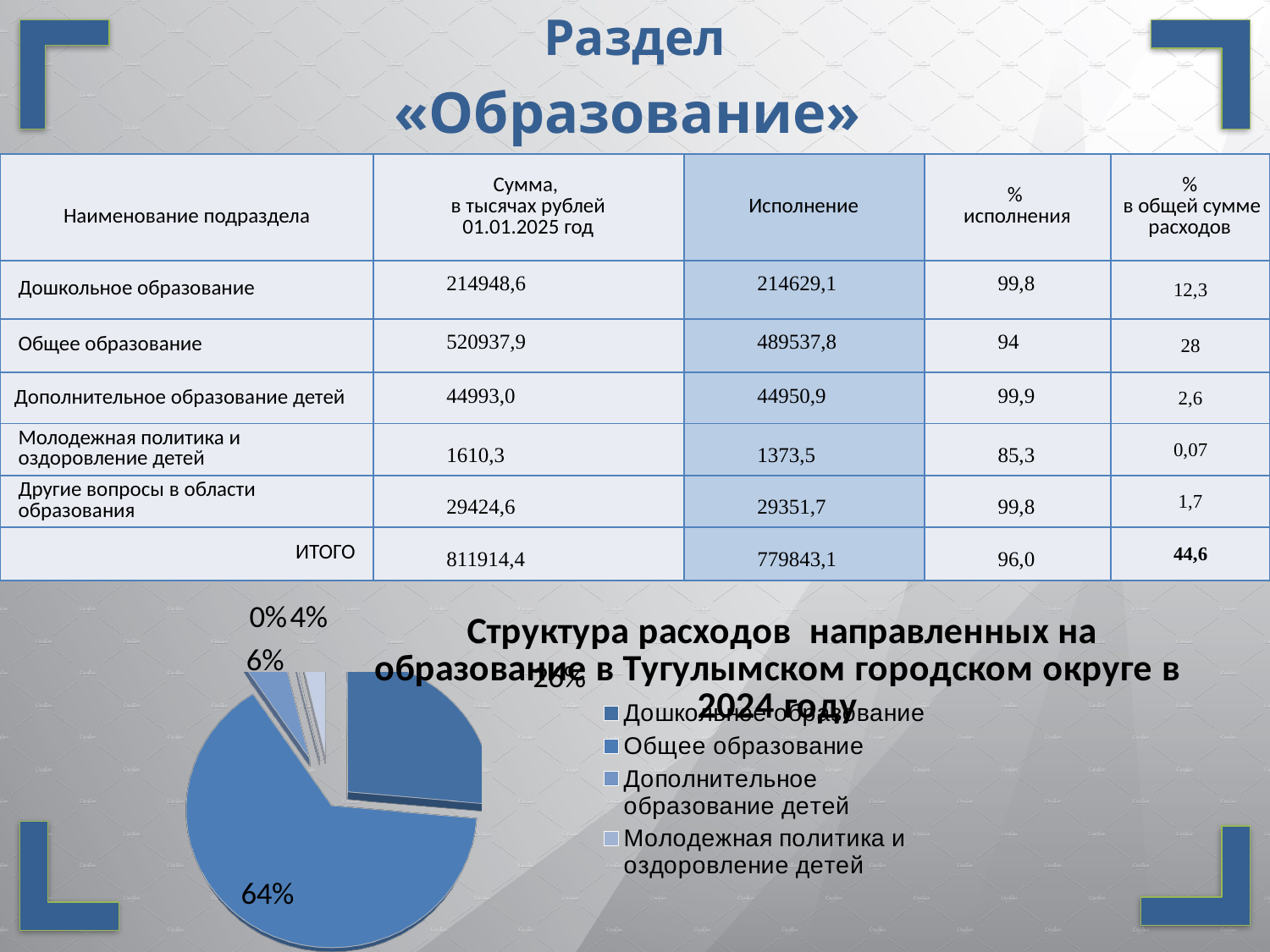
Which is larger on the pie chart: the 6% slice or the 4% slice? the 6% slice What kind of chart is shown on the slide? pie chart What is the difference in percentage points between the 64% slice and the 26% slice? 38 What is the smallest percentage label shown on the pie chart? 0% What share of the pie does the slice for Общее образование take? 64% Which legend entry is listed first in the pie chart's legend? Дошкольное образование Which legend entry is listed last in the pie chart's legend? Молодежная политика и оздоровление детей What share of the pie does the slice for Дошкольное образование take? 26% How many entries does the pie chart's legend list? 4 How many percentage labels are shown on the pie chart? 5 What is the largest percentage label shown on the pie chart? 64%